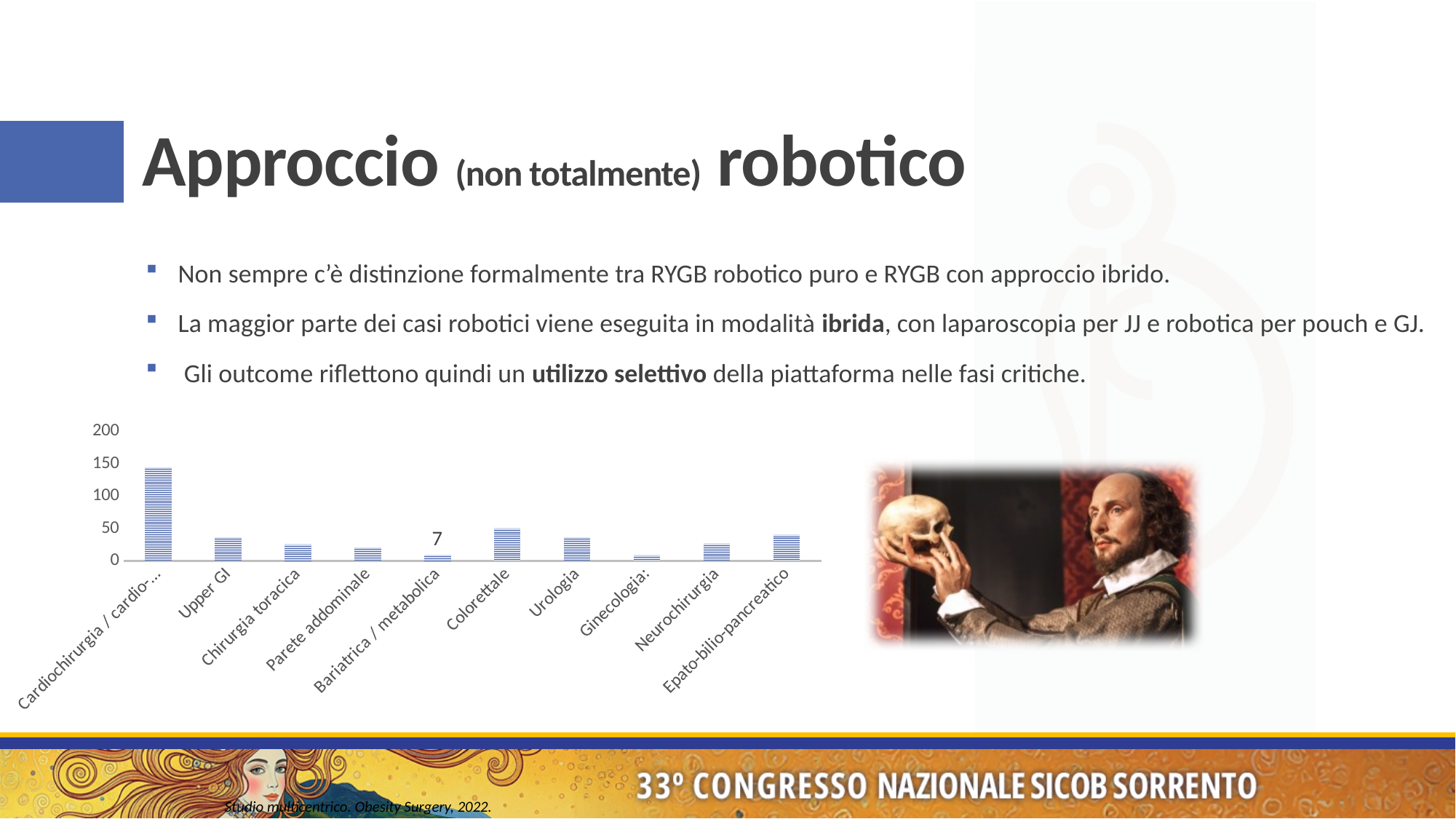
Which is larger, the value for Cardiochirurgia / cardio-... or the value for Colorettale? Cardiochirurgia / cardio-... Is the value for Upper GI greater or less than 50? less Which category has the highest bar in the chart? Cardiochirurgia / cardio-... What is the highest value shown on the y axis of the chart? 200 Which is larger, the value for Epato-bilio-pancreatico or the value for Ginecologia? Epato-bilio-pancreatico What kind of chart is shown on the slide? bar chart Is the value for Neurochirurgia greater or less than 50? less Is the value for Cardiochirurgia / cardio-... greater or less than 100? greater How many categories are shown on the x axis of the chart? 10 Which is larger, the value for Colorettale or the value for Bariatrica / metabolica? Colorettale What is the value shown for Bariatrica / metabolica? 7